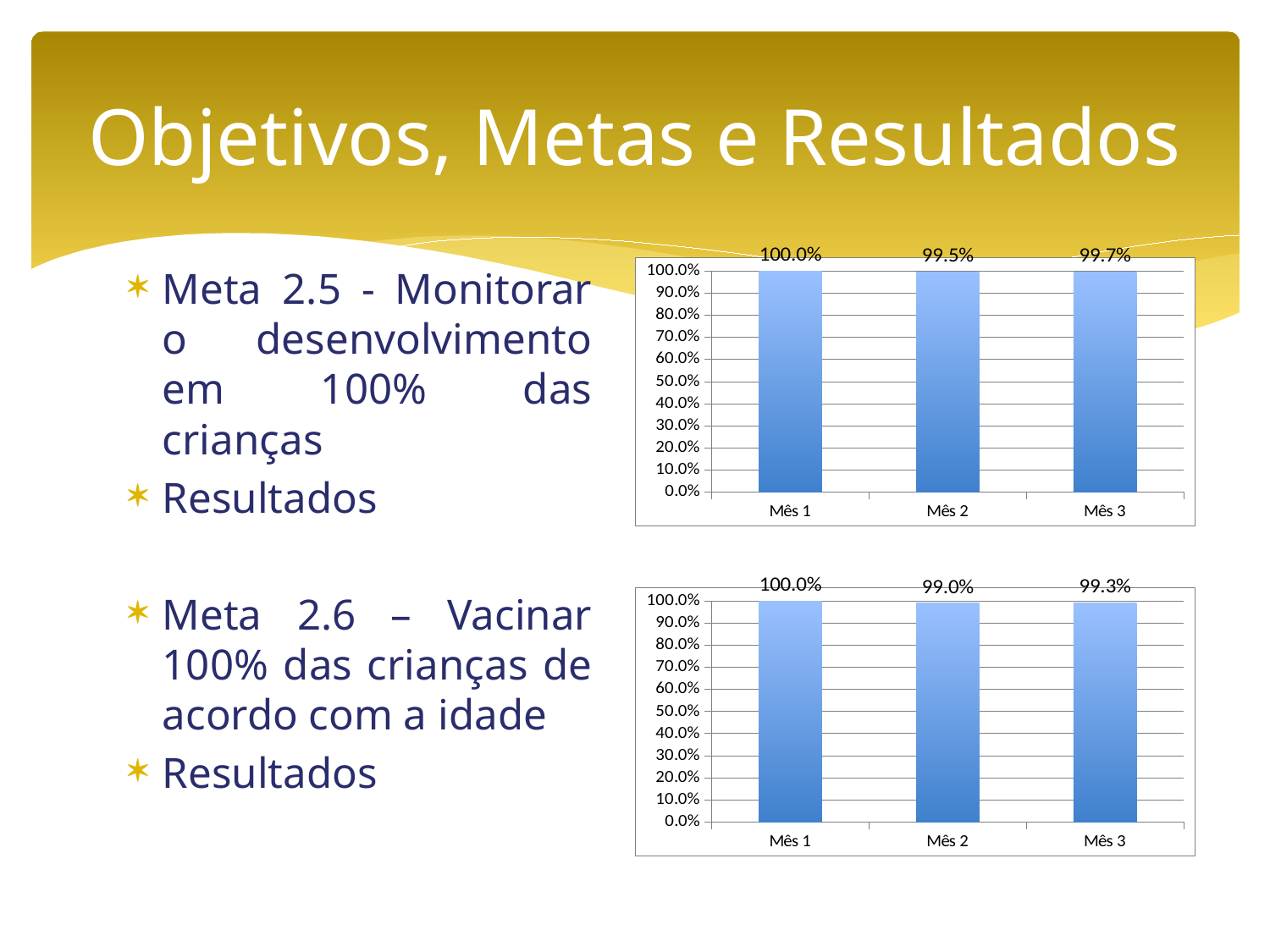
In the top chart, what is the value for Mês 3? 99.7% In the top chart, which month has the lowest value? Mês 2 In the bottom chart, which month has the lowest value? Mês 2 How many categories are shown in the top chart? 3 In the bottom chart, what is the value for Mês 2? 99.0% In the top chart, is the value for Mês 1 greater or less than 90.0%? greater In the top chart, what is the value for Mês 2? 99.5% In the bottom chart, what is the difference between the values for Mês 1 and Mês 3? 0.7% In the bottom chart, which is larger, the value for Mês 2 or Mês 3? Mês 3 In the top chart, what is the difference between the values for Mês 1 and Mês 2? 0.5% What kind of chart is the bottom chart? Bar chart In the bottom chart, what is the value for Mês 3? 99.3%